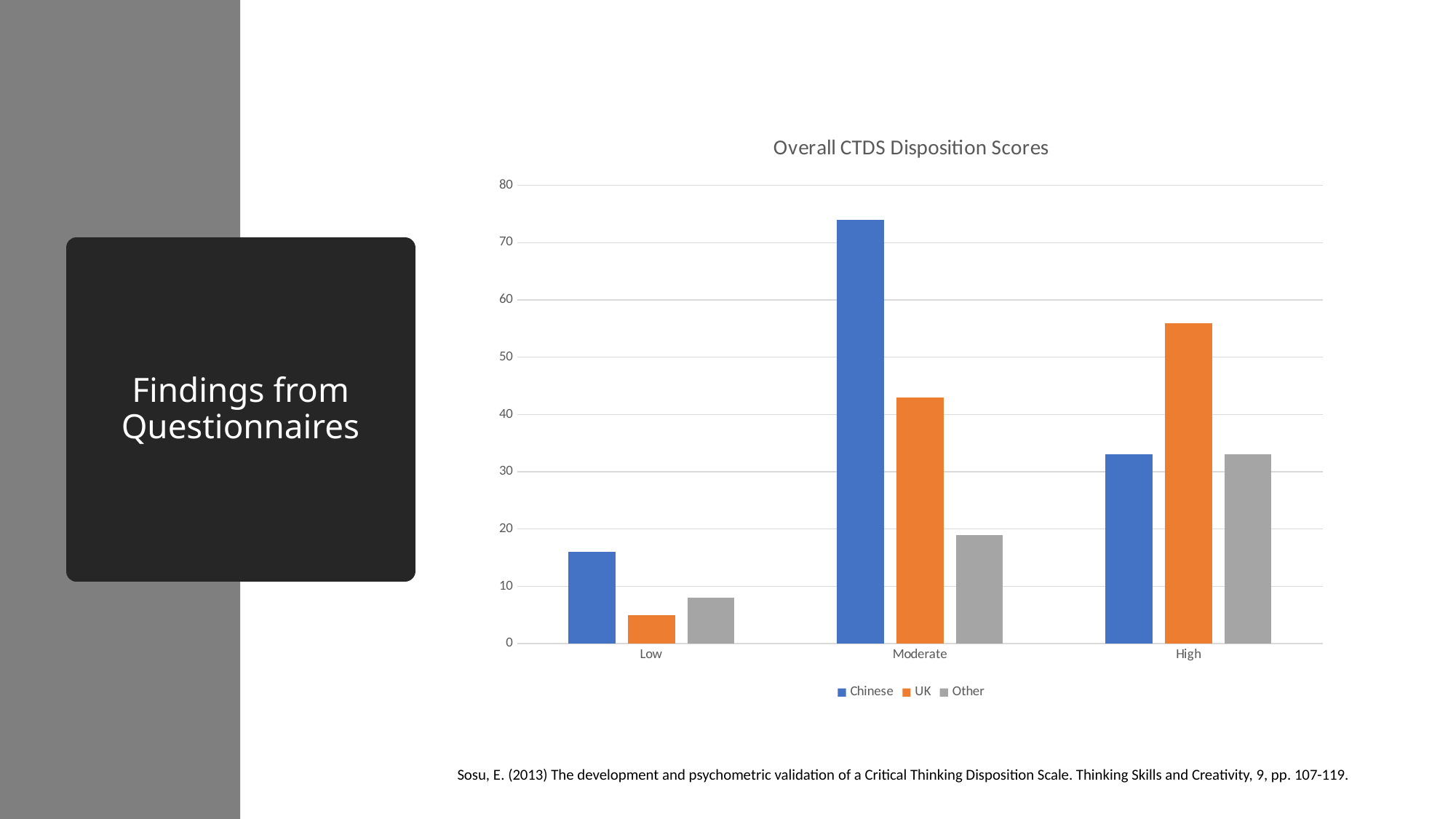
How many series does the legend list? 3 In the Moderate category, which is larger, the Chinese value or the UK value? Chinese Which series has the highest value in the High category? UK Is the UK value for Low greater or less than 10? less Is the Other value for Moderate greater or less than 20? less Is the UK value for High greater or less than 50? greater How many categories are shown on the x axis? 3 Which category has the highest Chinese value? Moderate What is the title of the chart? Overall CTDS Disposition Scores What kind of chart is shown on the slide? bar chart Which series has the lowest value in the Low category? UK